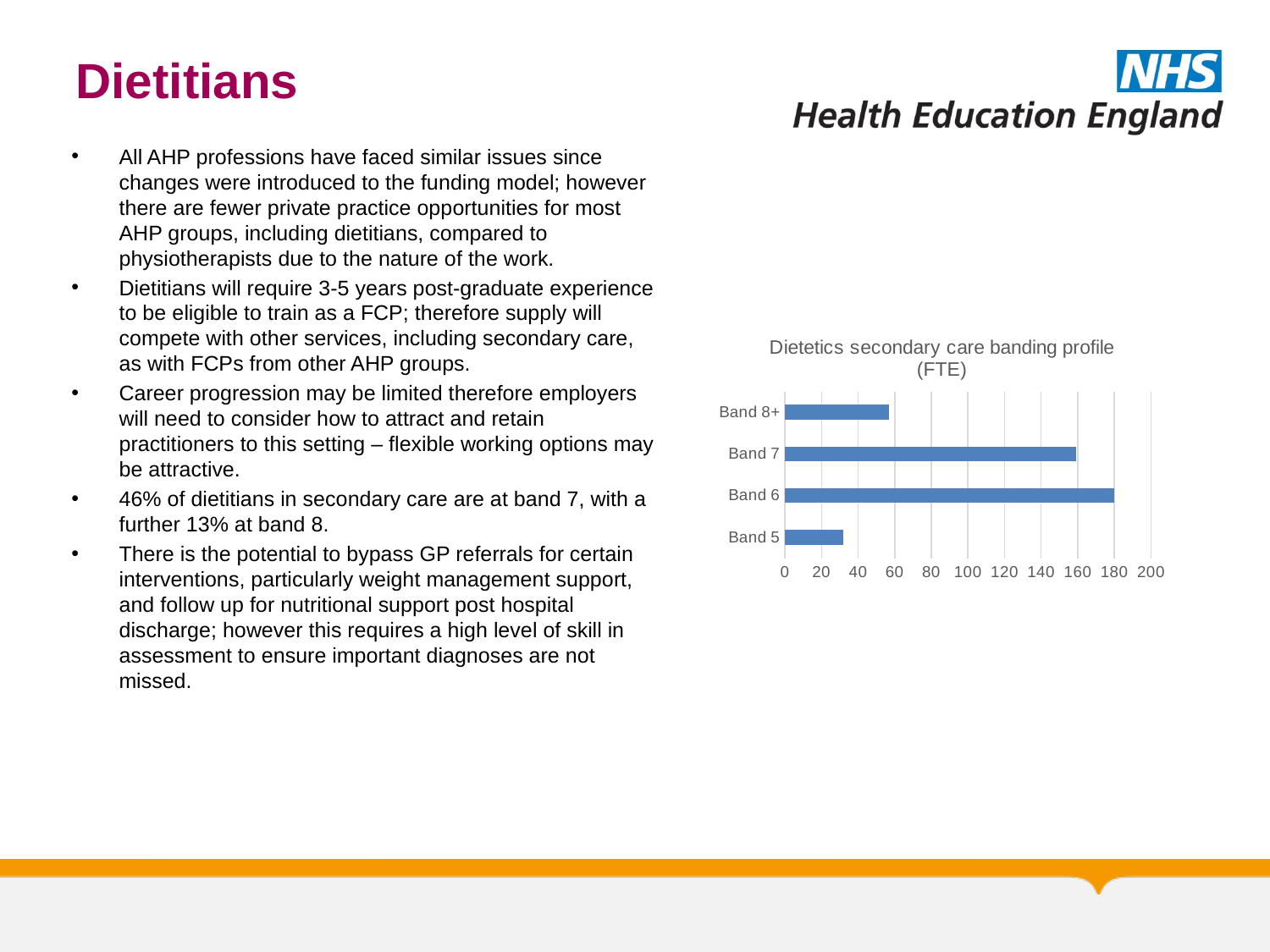
What is the title of the chart on the slide? Dietetics secondary care banding profile (FTE) Is the value for Band 5 greater or less than 40? less Is the value for Band 8+ greater or less than 60? less What is the highest value shown on the horizontal axis of the chart? 200 What kind of chart is shown on the slide? bar chart Which band has the highest value in the chart? Band 6 Is the value for Band 7 greater or less than 140? greater Which is larger, the value for Band 7 or the value for Band 8+? Band 7 Which band has the lowest value in the chart? Band 5 How many bands are plotted in the chart? 4